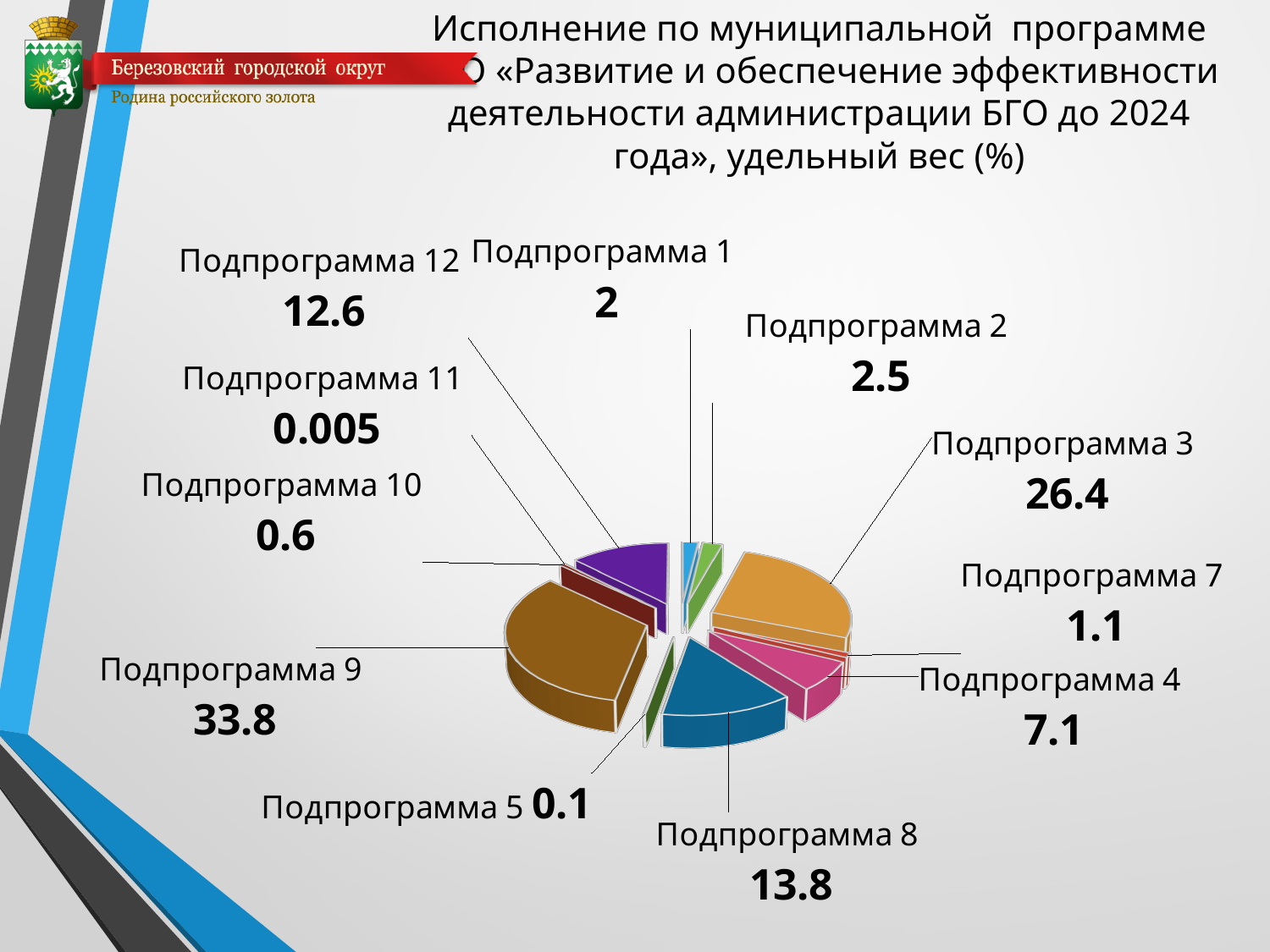
Which is larger, the value for Подпрограмма 4 or the value for Подпрограмма 2? Подпрограмма 4 What is the value shown for Подпрограмма 11? 0.005 What is the difference between the values for Подпрограмма 9 and Подпрограмма 3? 7.4 What kind of chart is shown on the slide? Pie chart What is the value shown for Подпрограмма 9? 33.8 How many subprograms are shown in the pie chart? 11 Which subprogram has the smallest share of the pie? Подпрограмма 11 What is the value shown for Подпрограмма 3? 26.4 What share of the pie does Подпрограмма 12 hold? 12.6 Which subprogram has the largest share of the pie? Подпрограмма 9 What is the difference between the values for Подпрограмма 8 and Подпрограмма 12? 1.2 What is the value shown for Подпрограмма 8? 13.8